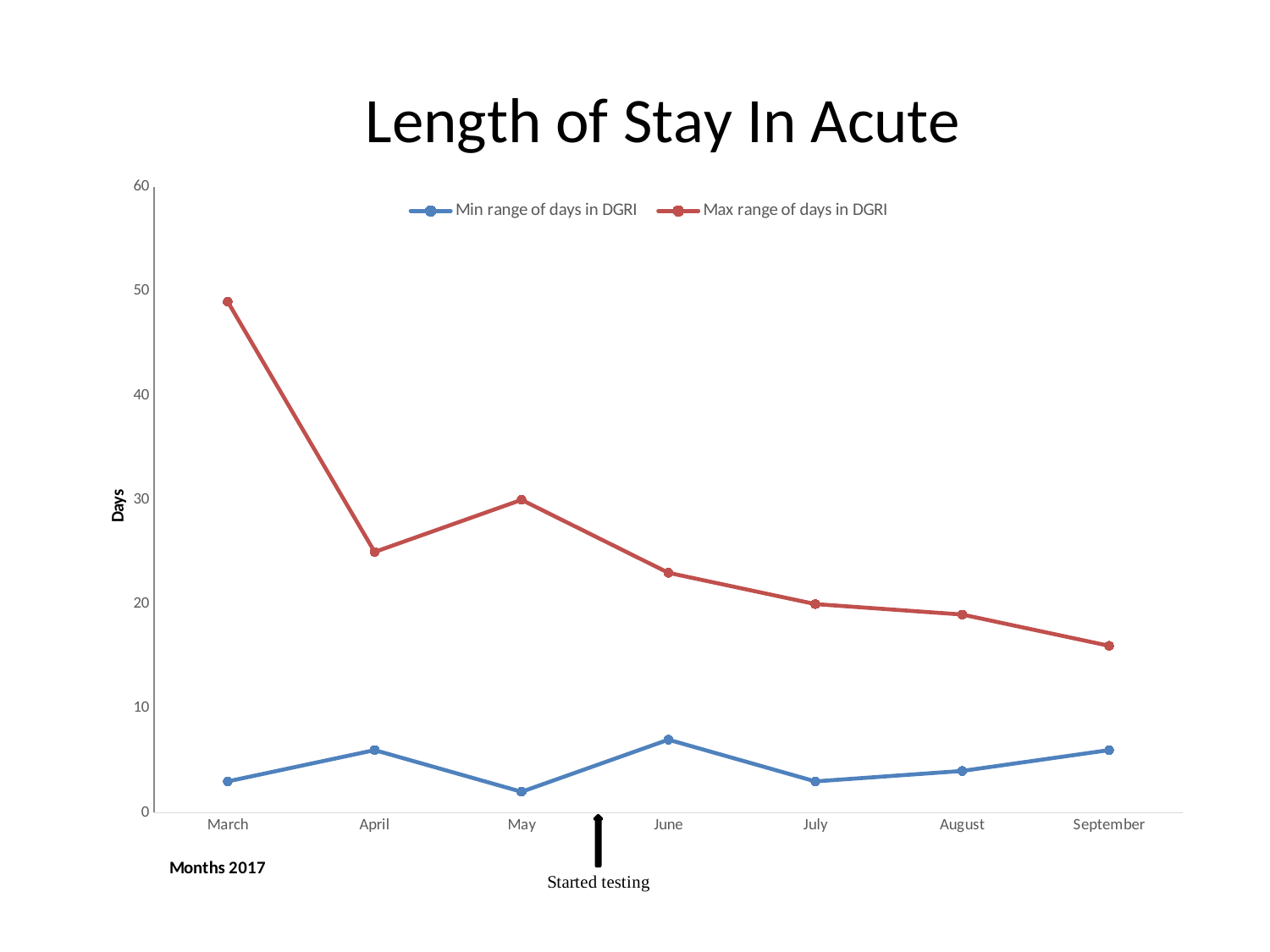
Does the Max range of days in DGRI generally rise or fall from March to September? Fall Is the value for Min range of days in DGRI in June greater or less than 10? less Is the value for Max range of days in DGRI in September greater or less than 20? less Is the value for Max range of days in DGRI in March greater or less than 40? greater Which month has the highest value for Max range of days in DGRI? March What kind of chart is shown on the slide? Line chart What is the title of the chart? Length of Stay In Acute Which month has the lowest value for Min range of days in DGRI? May Which is larger: the Max range of days in DGRI in April or in May? May How many series does the legend list? 2 How many months are plotted along the x axis? 7 Which month has the lowest value for Max range of days in DGRI? September